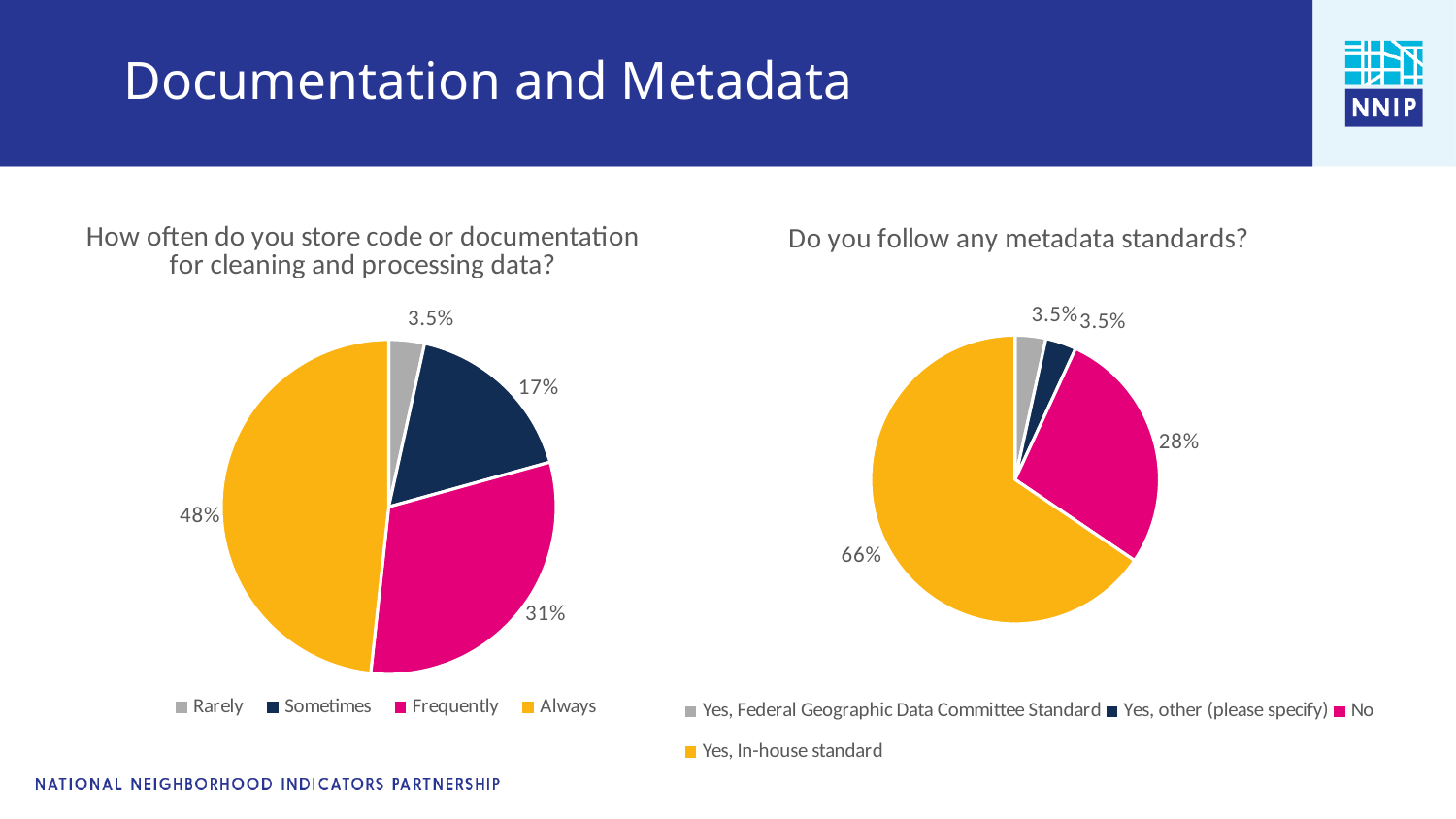
In the chart titled "Do you follow any metadata standards?", which is larger: the "No" share or the "Yes, In-house standard" share? Yes, In-house standard In the chart titled "Do you follow any metadata standards?", what share of respondents answered "No"? 28% In the chart titled "How often do you store code or documentation for cleaning and processing data?", what share of respondents answered "Sometimes"? 17% In the chart titled "Do you follow any metadata standards?", what colour is the "No" slice? Pink (magenta) In the chart titled "How often do you store code or documentation for cleaning and processing data?", which category has the smallest slice? Rarely In the chart titled "Do you follow any metadata standards?", which category has the largest slice? Yes, In-house standard In the chart titled "Do you follow any metadata standards?", what share of respondents answered "Yes, In-house standard"? 66% In the chart titled "How often do you store code or documentation for cleaning and processing data?", what is the difference between the "Always" and "Frequently" shares? 17% What kind of chart is the one titled "Do you follow any metadata standards?"? Pie chart In the chart titled "How often do you store code or documentation for cleaning and processing data?", how many categories does the legend list? 4 In the chart titled "Do you follow any metadata standards?", what is the difference between the "Yes, In-house standard" and "No" shares? 38% In the chart titled "How often do you store code or documentation for cleaning and processing data?", what share of respondents answered "Always"? 48%